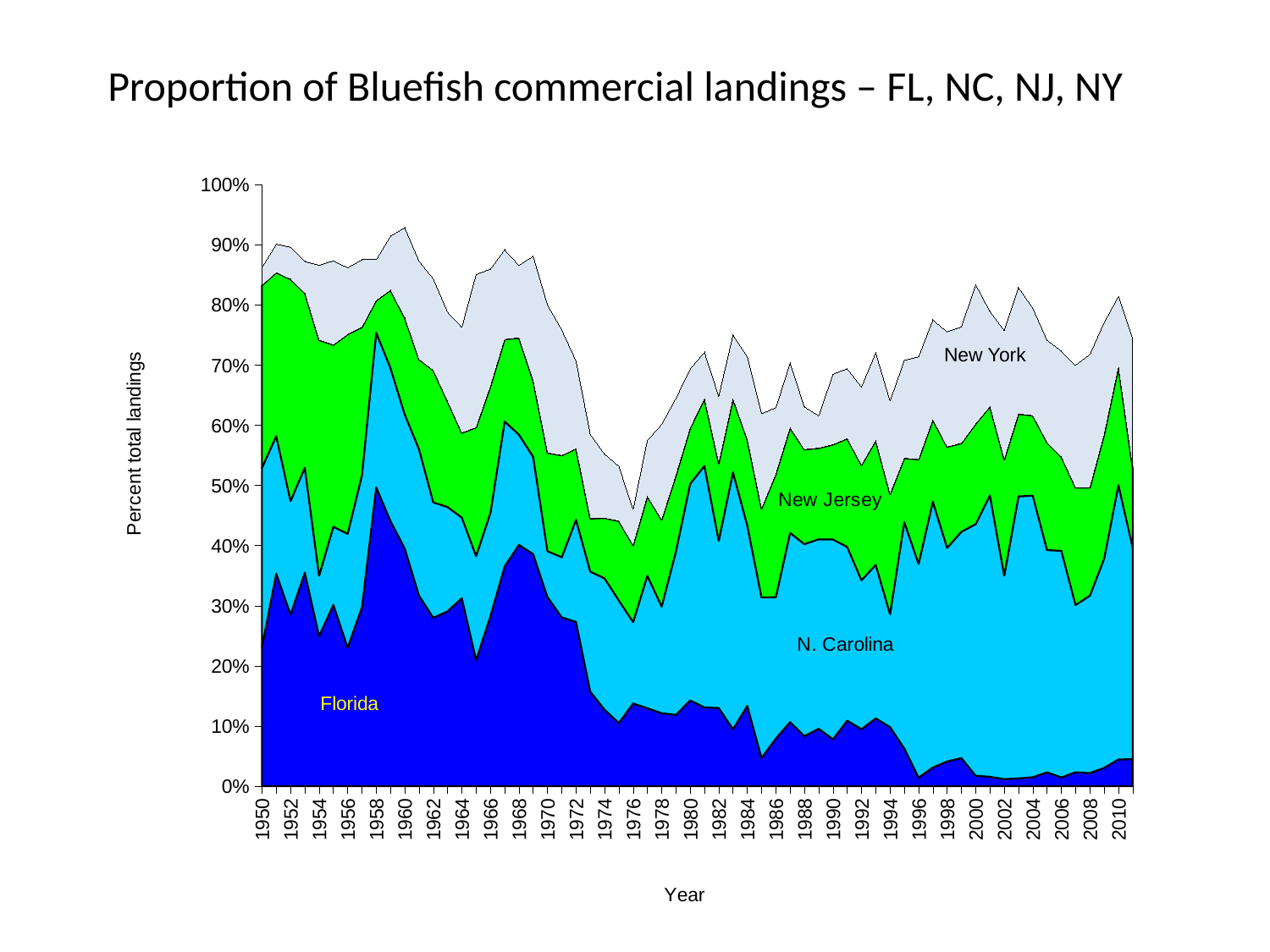
What is the title of the chart? Proportion of Bluefish commercial landings – FL, NC, NJ, NY Which state's share is larger in 1951, Florida or New York? Florida Is the combined share of the four states in 1976 greater or less than 50%? less Does Florida's share of landings rise or fall from 1950 to 2010? fall Is the combined share of the four states in 1960 greater or less than 90%? greater What is the label on the vertical axis? Percent total landings Is Florida's share of landings in 1959 greater or less than 40%? greater What kind of chart is shown on the slide? stacked area chart How many states (series) are stacked in the chart? 4 Which state's share is larger in 2000, Florida or N. Carolina? N. Carolina